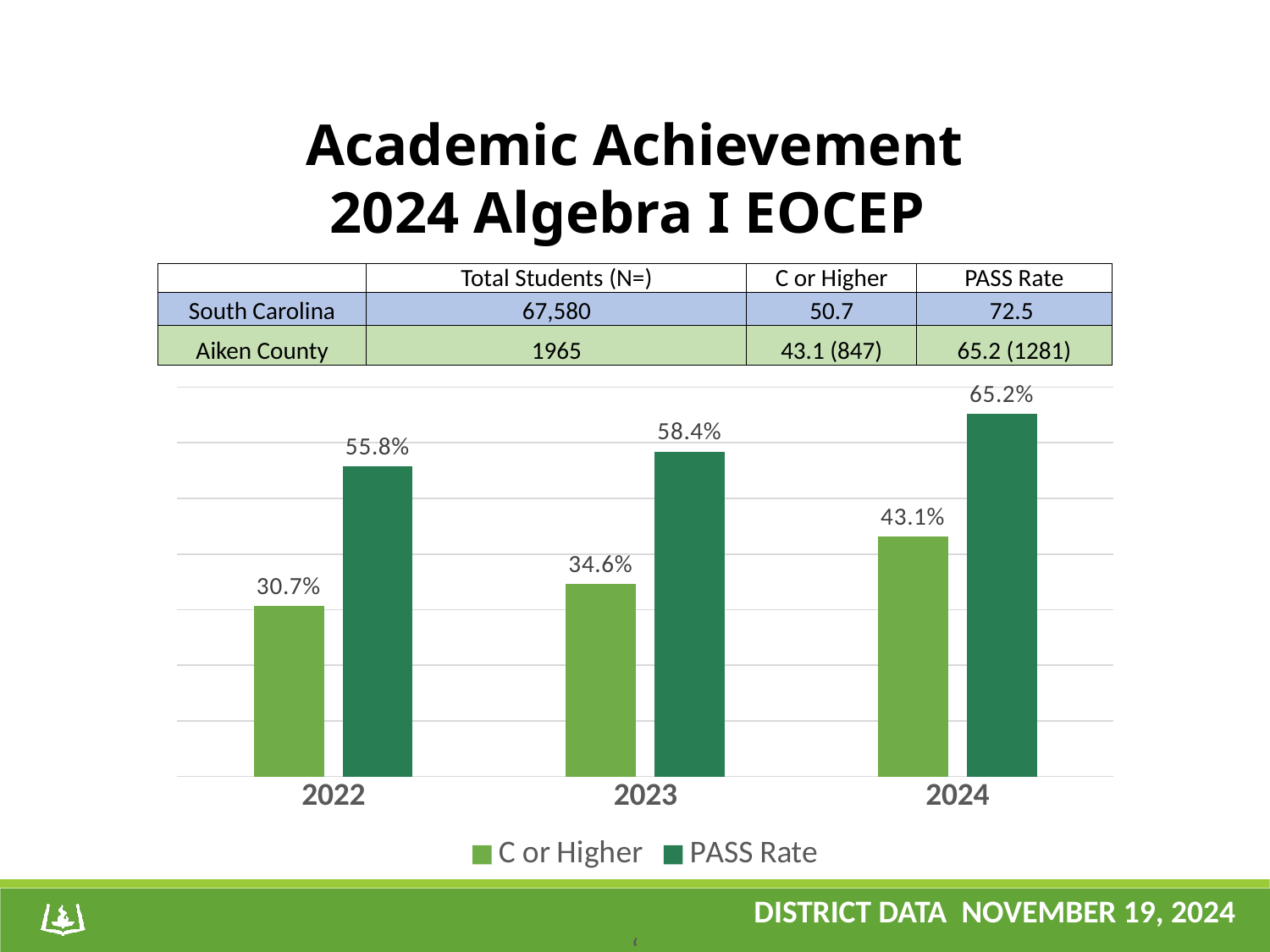
What is the difference between the PASS Rate and the C or Higher value in 2024? 22.1% Does the C or Higher value rise or fall from 2022 to 2024? Rise Which is larger: the PASS Rate for 2023 or the PASS Rate for 2022? PASS Rate for 2023 What kind of chart is shown on the slide? Bar chart How many years are shown on the x axis of the chart? 3 What is the PASS Rate value for 2022? 55.8% What is the C or Higher value for 2023? 34.6% Which year has the lowest C or Higher value? 2022 What is the PASS Rate value for 2024? 65.2% How many series does the chart legend list? 2 Which year has the highest PASS Rate? 2024 What is the C or Higher value for 2022? 30.7%